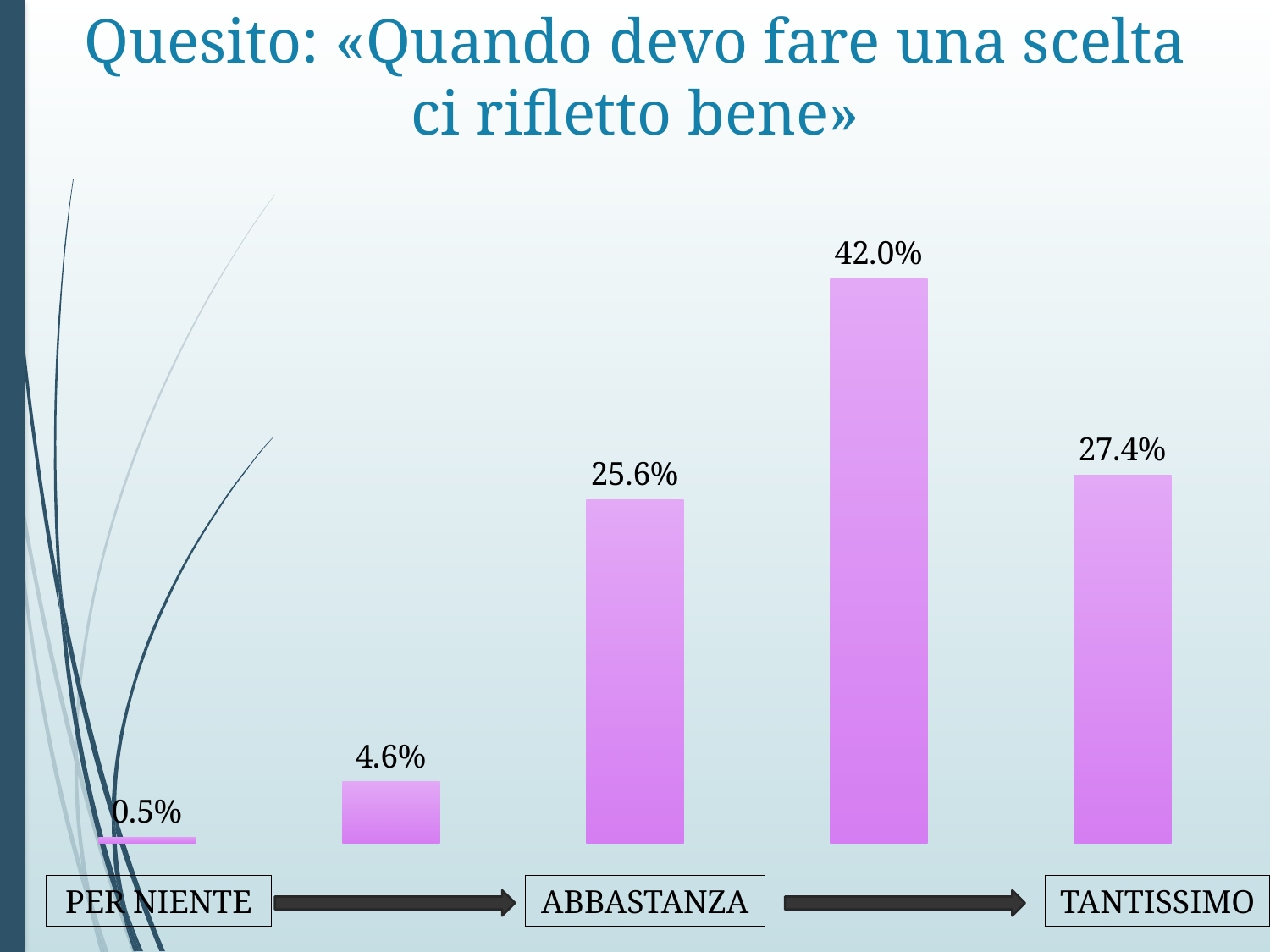
Which is larger, the value for ABBASTANZA or the value for TANTISSIMO? TANTISSIMO What kind of chart is shown on the slide? bar chart What is the value of the bar labelled ABBASTANZA? 25.6% What is the value of the bar labelled PER NIENTE? 0.5% Which labelled category has the lowest value? PER NIENTE What is the title of the slide containing the chart? Quesito: «Quando devo fare una scelta ci rifletto bene» What is the value of the second bar from the left? 4.6% How many bars does the chart contain? 5 What is the value of the tallest bar in the chart? 42.0% What is the difference between the values for TANTISSIMO and ABBASTANZA? 1.8% What is the difference between the tallest bar and the bar labelled TANTISSIMO? 14.6% What is the value of the bar labelled TANTISSIMO? 27.4%